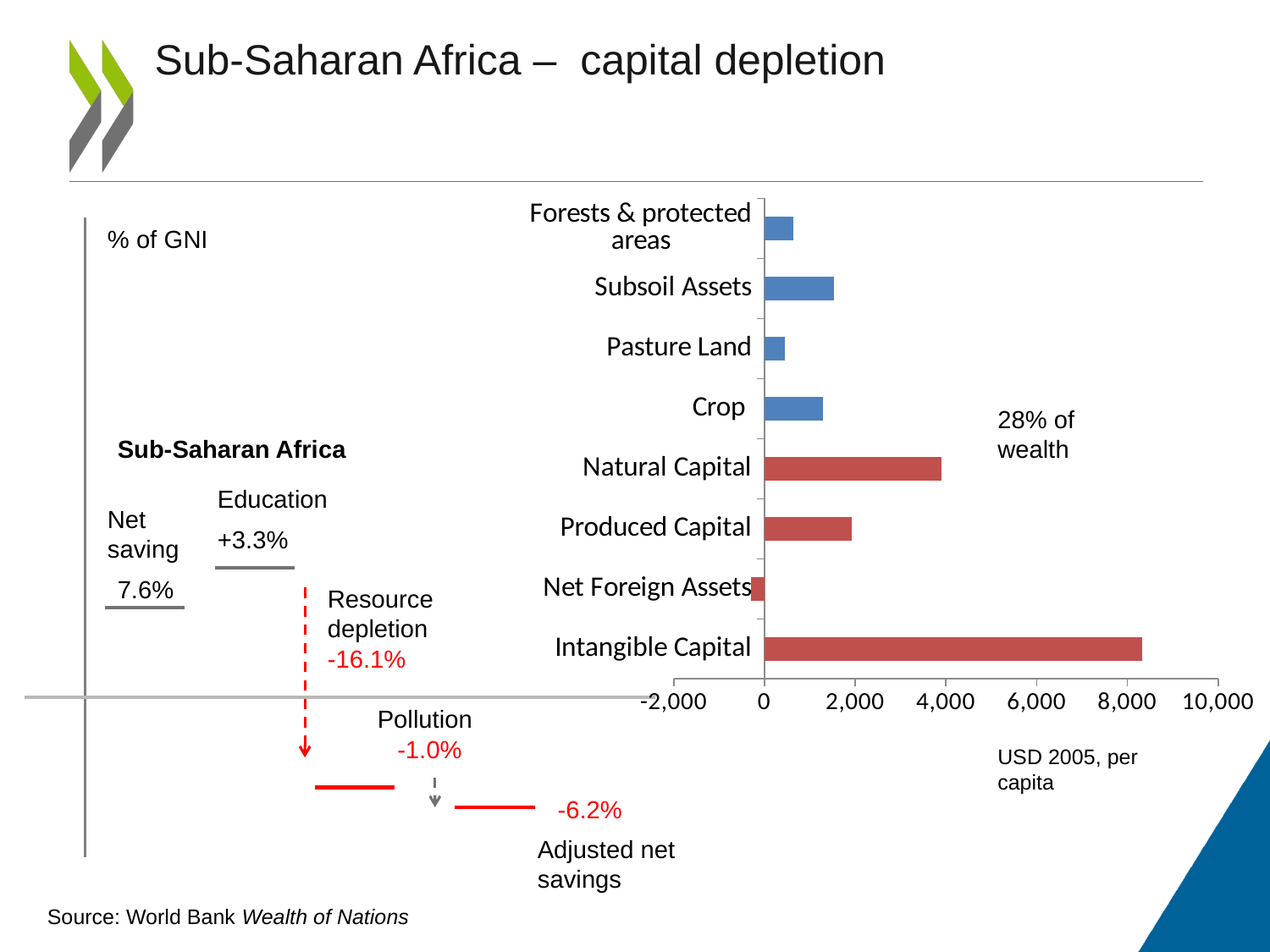
In the bar chart on the right, how many categories are plotted? 8 In the bar chart on the right, what unit is given for the values on the x axis? USD 2005, per capita In the bar chart on the right, which category has the lowest value? Net Foreign Assets In the bar chart on the right, is the value for Intangible Capital greater or less than 6,000? greater What kind of chart is shown on the right of the slide? bar chart In the left diagram (% of GNI), what is the value shown for Adjusted net savings? -6.2% In the bar chart on the right, which is larger: Natural Capital or Produced Capital? Natural Capital In the bar chart on the right, which category has the highest value? Intangible Capital In the left diagram (% of GNI), what is the value shown for Resource depletion? -16.1% In the bar chart on the right, is the value for Net Foreign Assets greater or less than 0? less In the bar chart on the right, which is larger: Subsoil Assets or Pasture Land? Subsoil Assets In the bar chart on the right, is the value for Pasture Land greater or less than 1,000? less